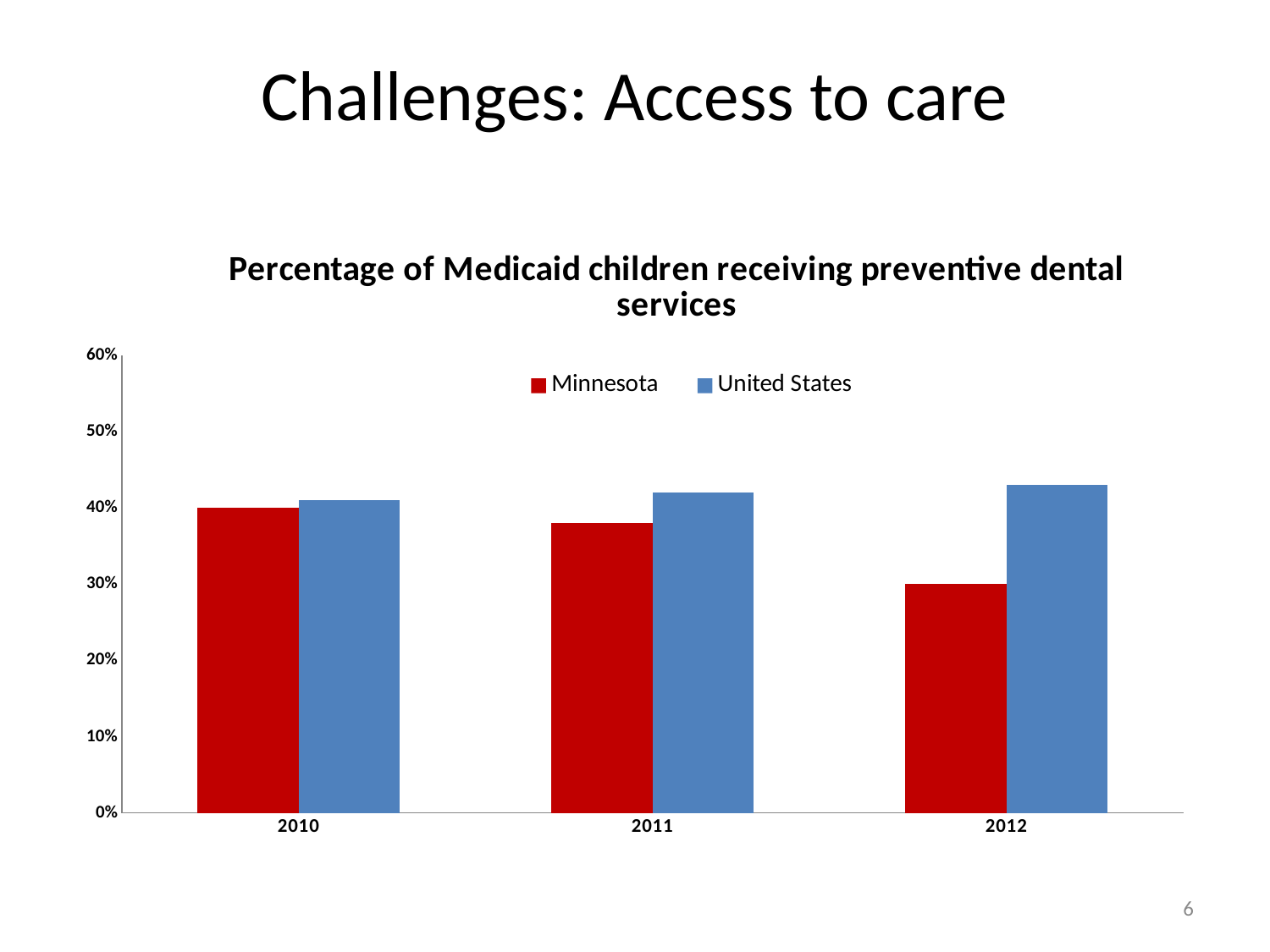
How many years are shown on the x axis? 3 Do the Minnesota values rise or fall from 2010 to 2012? fall Is the value for Minnesota in 2011 greater or less than 40%? less In 2012, which is larger, Minnesota or United States? United States Is the value for Minnesota in 2012 greater or less than 20%? greater Which series is shown in red? Minnesota How many series does the legend list? 2 In which year is the Minnesota value lowest? 2012 What kind of chart is shown on the slide? bar chart Is the value for Minnesota in 2012 greater or less than 40%? less What is the title of the chart? Percentage of Medicaid children receiving preventive dental services